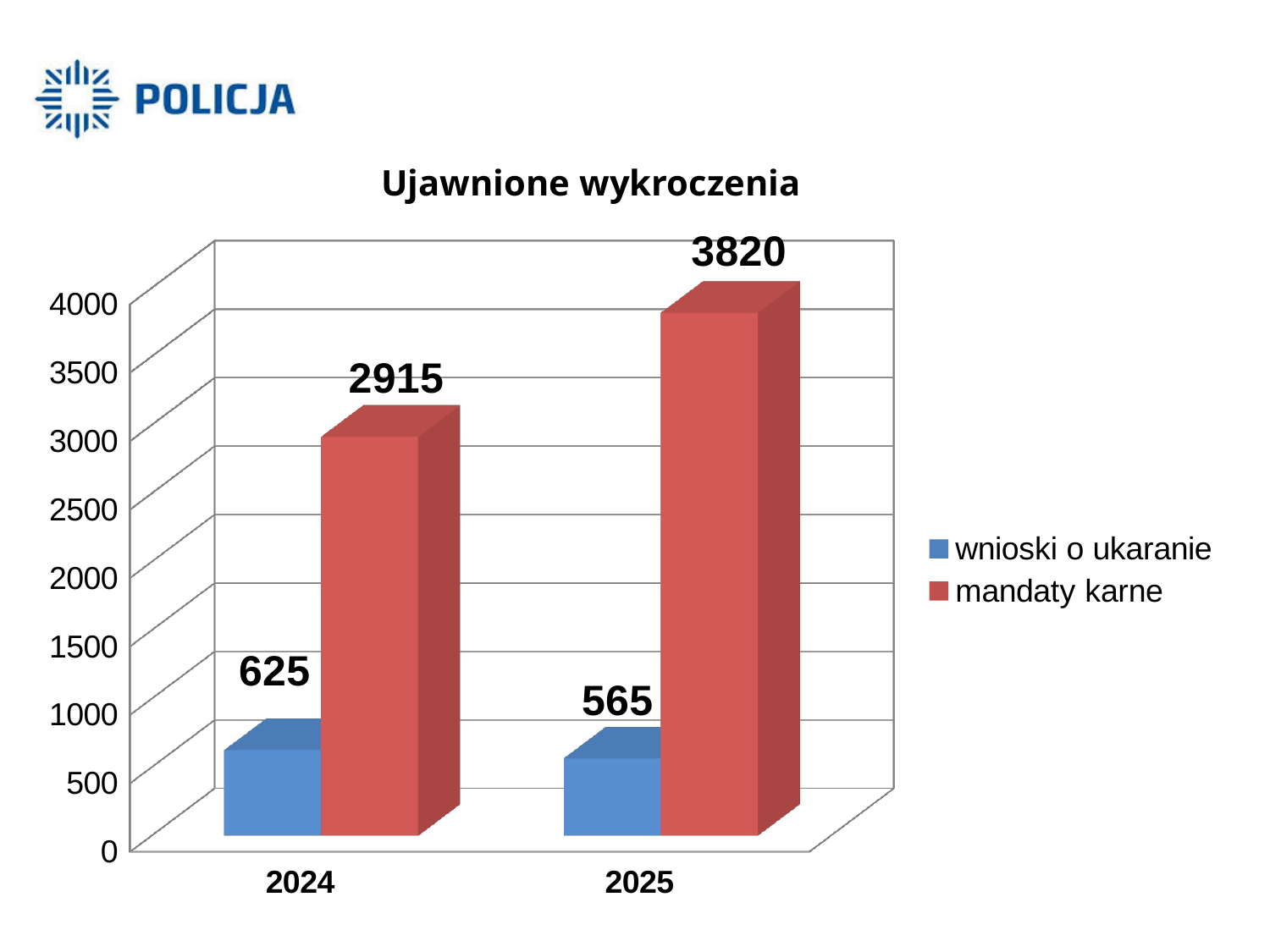
What is the value for 'wnioski o ukaranie' in 2024? 625 In which year is 'wnioski o ukaranie' lowest? 2025 What is the value for 'wnioski o ukaranie' in 2025? 565 Which is larger: 'mandaty karne' in 2024 or 'wnioski o ukaranie' in 2024? mandaty karne in 2024 How many series does the legend list? 2 What kind of chart is shown on the slide? bar chart What is the difference between 'wnioski o ukaranie' in 2024 and in 2025? 60 What is the difference between 'mandaty karne' in 2025 and in 2024? 905 How many years are shown on the x axis? 2 What is the value for 'mandaty karne' in 2025? 3820 What is the value for 'mandaty karne' in 2024? 2915 In which year is 'mandaty karne' highest? 2025